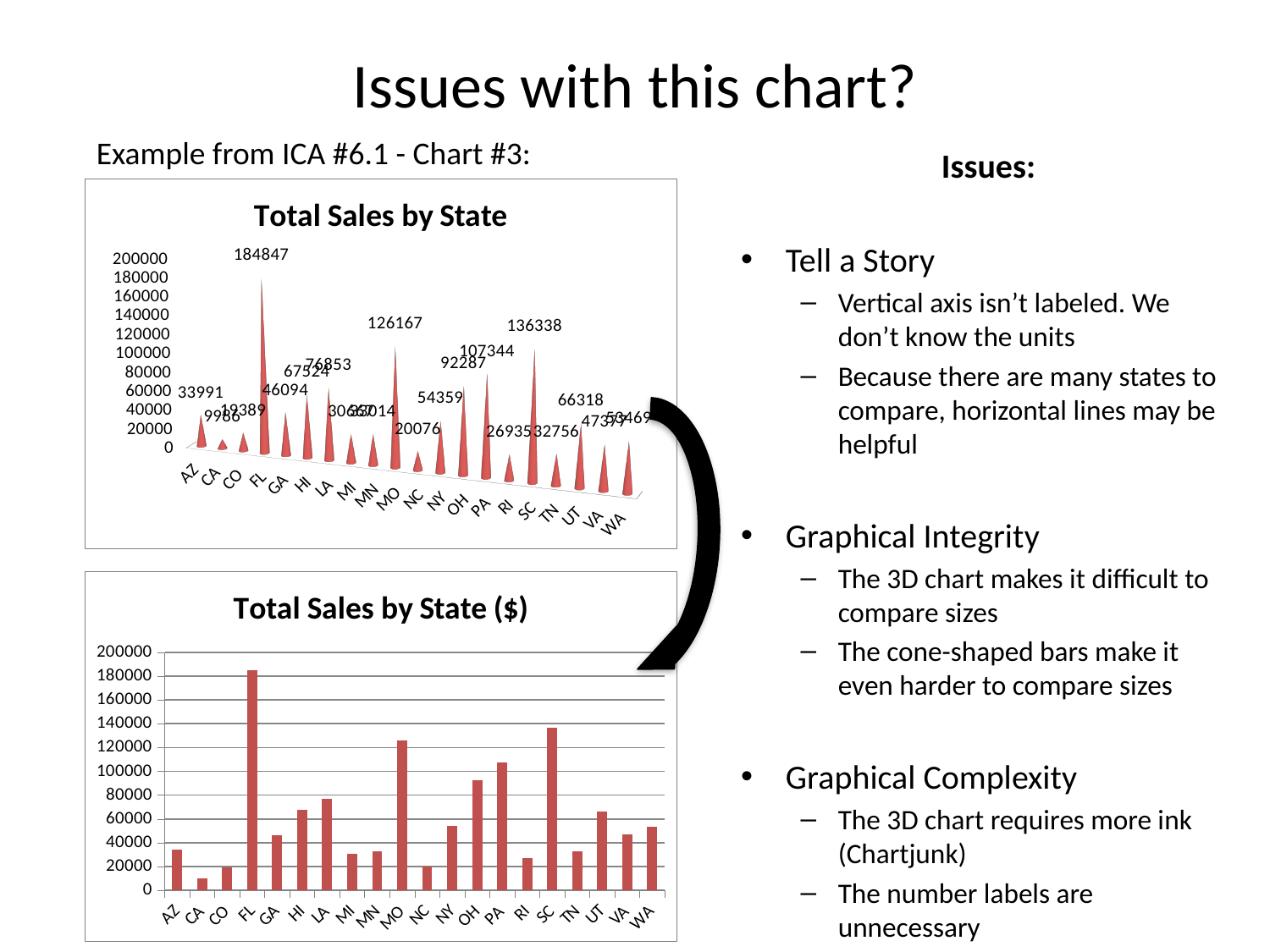
What kind of chart is the bottom chart 'Total Sales by State ($)'? bar chart In the top chart 'Total Sales by State', what is the value for MO? 126167 In the top chart 'Total Sales by State', what is the difference between the values for FL and SC? 48509 In the top chart 'Total Sales by State', which state has the highest value? FL In the top chart 'Total Sales by State', what is the value for FL? 184847 In the top chart 'Total Sales by State', what is the value for CA? 9986 In the top chart 'Total Sales by State', what is the value for SC? 136338 In the bottom chart 'Total Sales by State ($)', is the value for MO greater or less than 120000? greater How many states are shown on the x axis of the bottom chart 'Total Sales by State ($)'? 20 In the top chart 'Total Sales by State', which is larger, the value for PA or the value for OH? PA In the top chart 'Total Sales by State', which state has the lowest value? CA In the bottom chart 'Total Sales by State ($)', is the value for NC greater or less than 40000? less